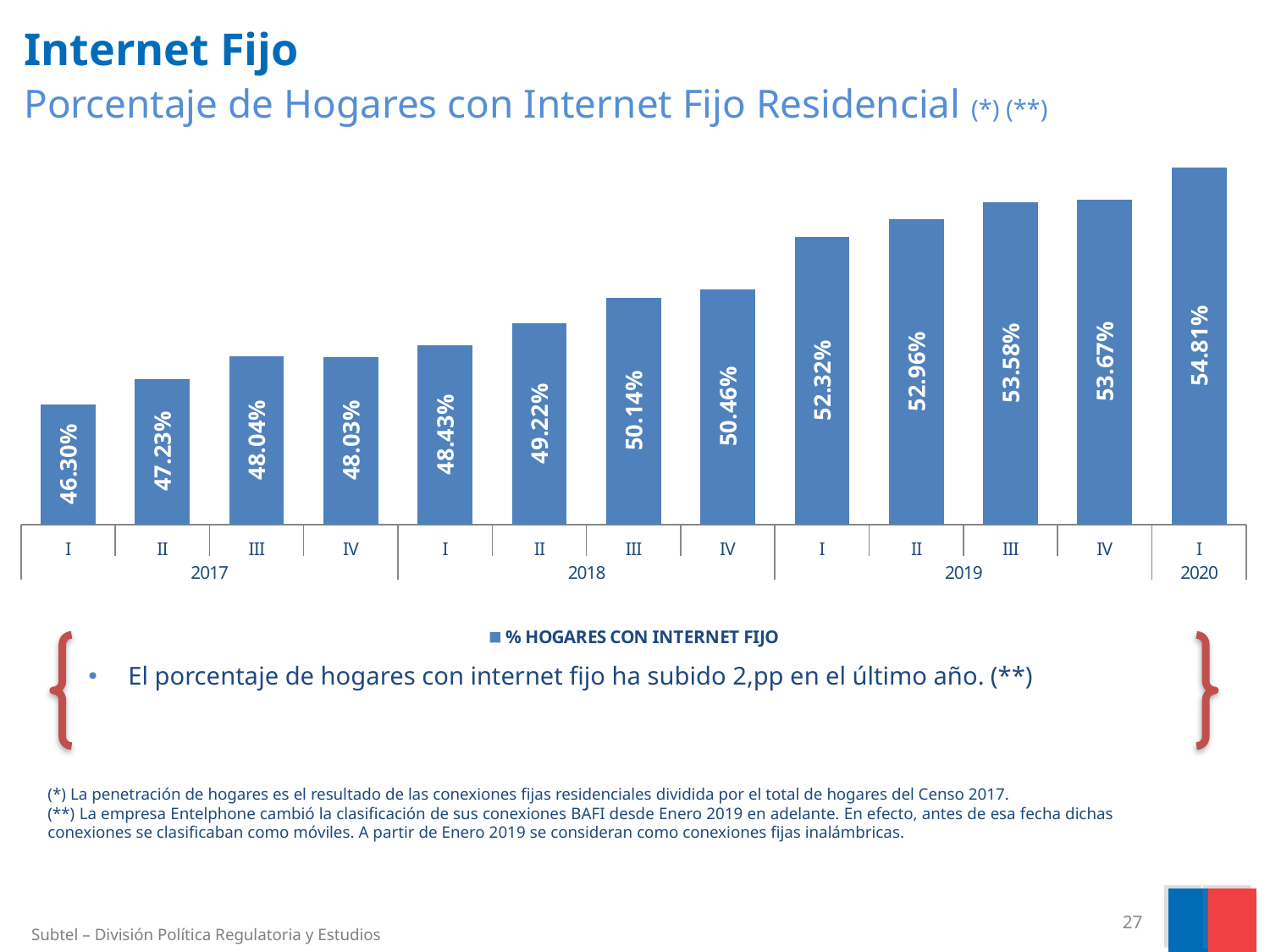
What is the difference between the value for quarter IV of 2018 and quarter I of 2019? 1.86% Which quarter has the highest percentage of households with fixed internet? I 2020 What is the value for quarter I of 2020? 54.81% How many series does the legend list? 1 Which quarter has the lowest percentage of households with fixed internet? I 2017 What is the value for quarter III of 2018? 50.14% What is the legend entry for the series shown in the chart? % HOGARES CON INTERNET FIJO What is the difference between the value for quarter I of 2020 and quarter I of 2019? 2.49% How many bars are plotted in the chart? 13 What kind of chart is shown on the slide? Bar chart What is the value for quarter I of 2017? 46.30% Which is larger, the value for quarter II of 2018 or quarter IV of 2017? II 2018